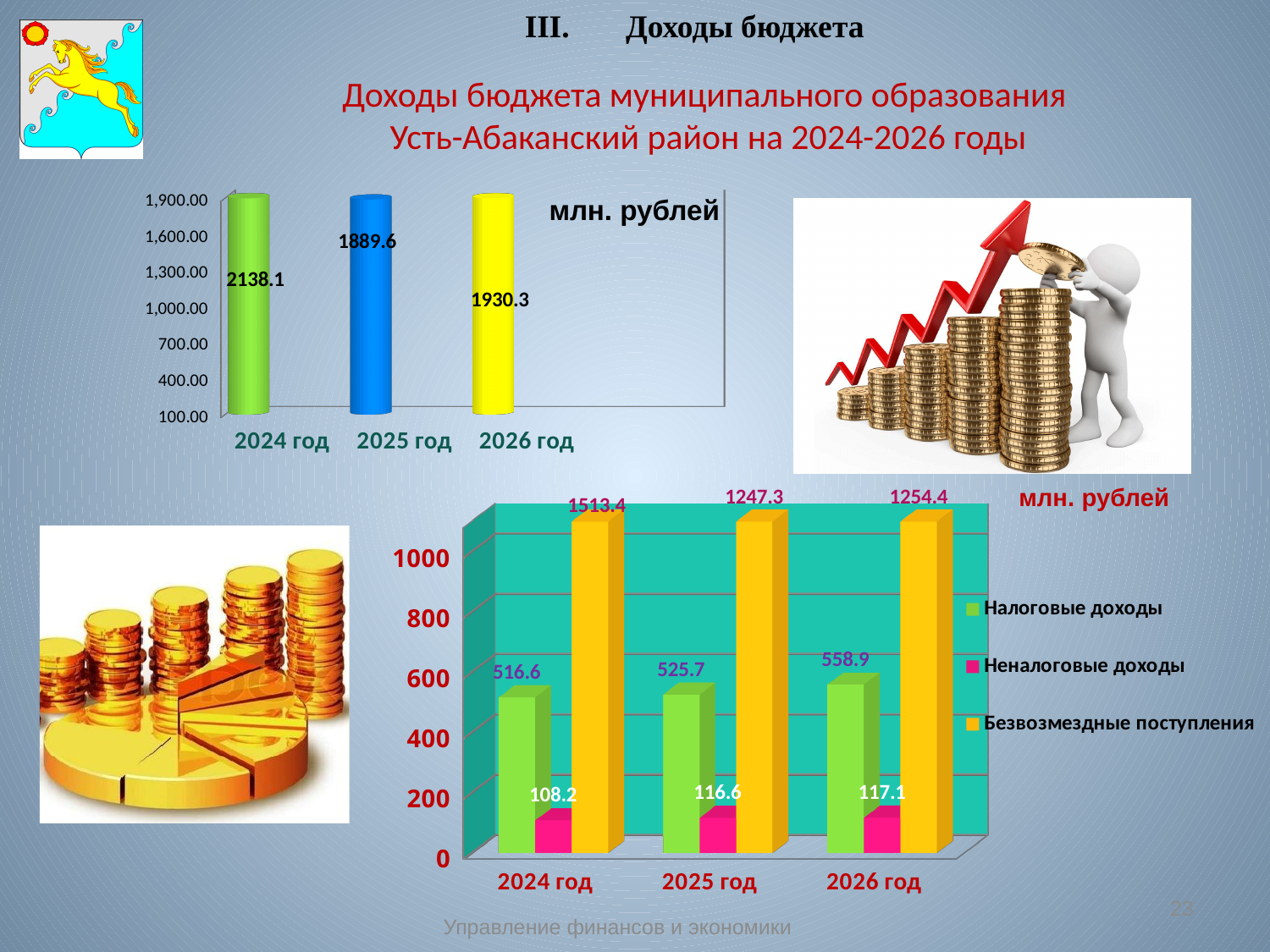
In the top chart, what is the difference between the values for 2024 год and 2025 год? 248.5 In the top chart, what is the value for 2024 год? 2138.1 In the bottom chart, what is the value of Налоговые доходы for 2026 год? 558.9 In the bottom chart, in which year is Безвозмездные поступления highest? 2024 год What kind of chart is the bottom chart? bar chart In the top chart, which year has the lowest value? 2025 год In the bottom chart, how many series does the legend list? 3 In the bottom chart, do the values of Налоговые доходы rise or fall from 2024 год to 2026 год? rise In the top chart, what is the value for 2025 год? 1889.6 In the top chart, which is larger: the value for 2025 год or 2026 год? 2026 год In the bottom chart, what is the difference between Налоговые доходы in 2026 год and 2024 год? 42.3 In the bottom chart, what is the value of Безвозмездные поступления for 2025 год? 1247.3